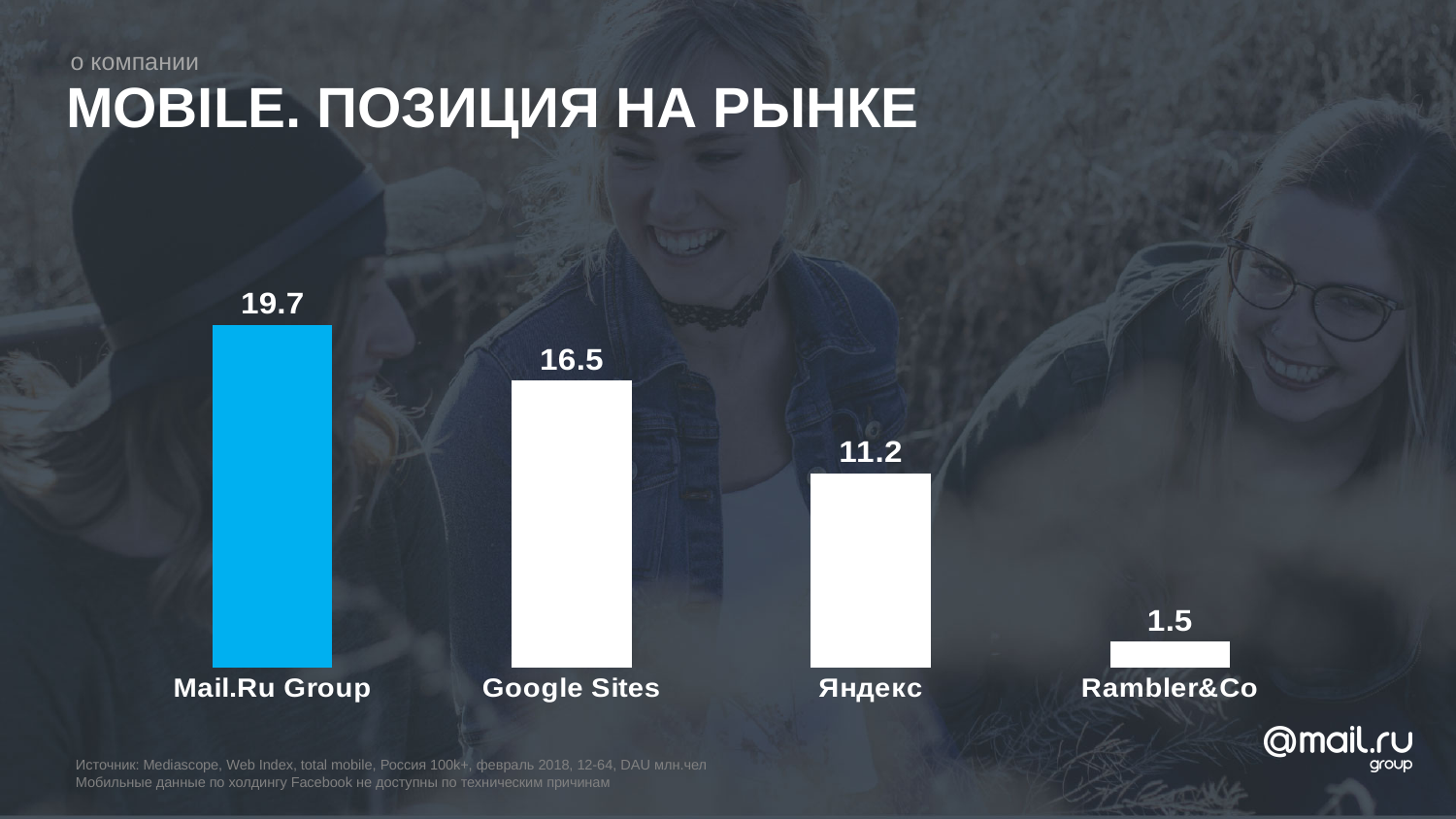
Which bar is coloured blue rather than white? Mail.Ru Group What is the value for Mail.Ru Group? 19.7 Which category has the highest value? Mail.Ru Group How many categories are shown in the chart? 4 What is the value for Rambler&Co? 1.5 Which is larger, the value for Google Sites or the value for Яндекс? Google Sites What is the value for Google Sites? 16.5 What is the value for Яндекс? 11.2 What is the difference between the values for Яндекс and Rambler&Co? 9.7 What kind of chart is shown on the slide? bar chart What is the difference between the values for Mail.Ru Group and Google Sites? 3.2 Which category has the lowest value? Rambler&Co